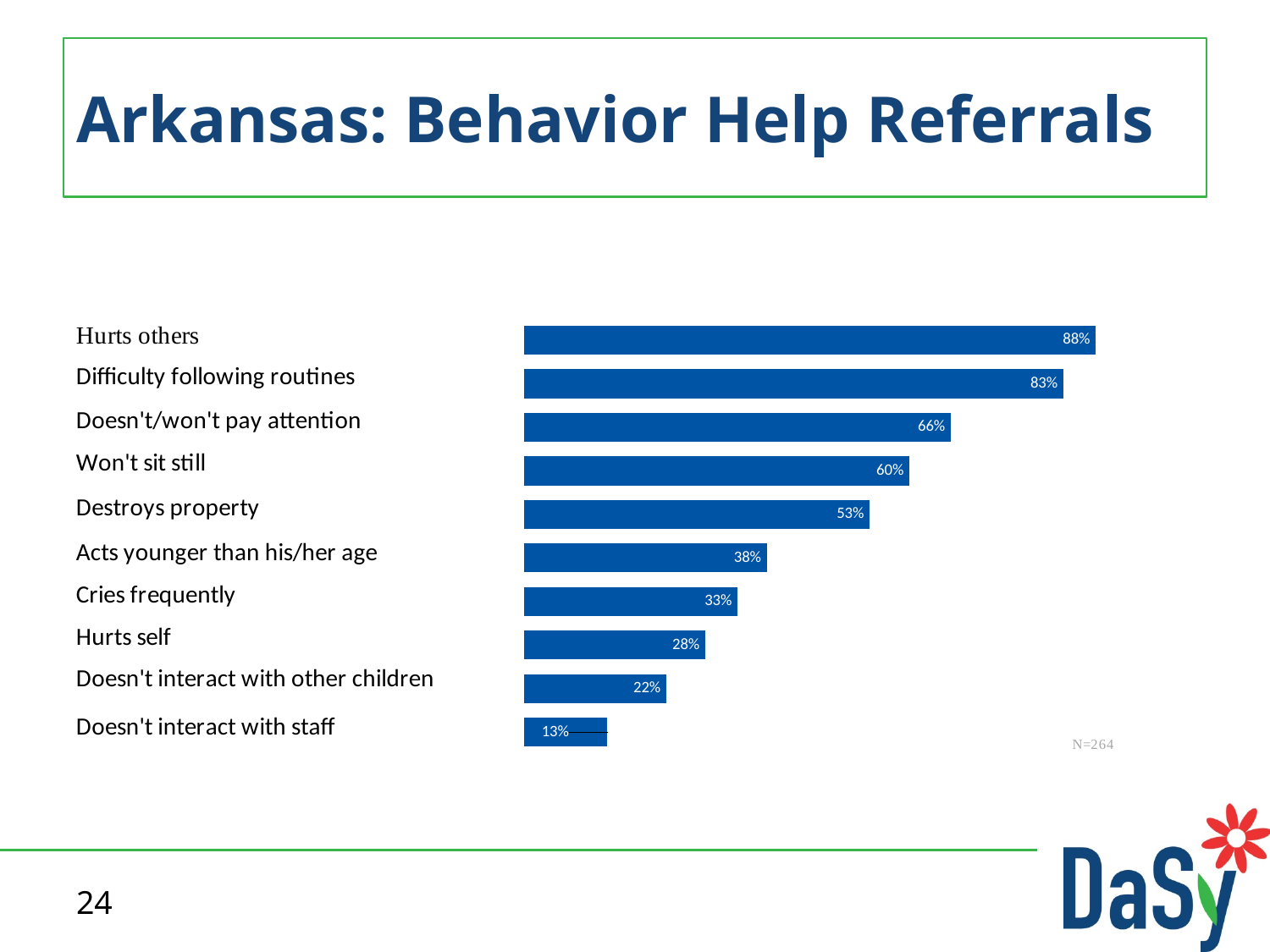
Which behavior has the lowest percentage? Doesn't interact with staff What is the difference between the percentages for "Difficulty following routines" and "Doesn't/won't pay attention"? 17% What percentage is shown for "Won't sit still"? 60% What is the difference between the percentages for "Hurts self" and "Doesn't interact with staff"? 15% What percentage is shown for "Hurts others"? 88% What percentage is shown for "Cries frequently"? 33% What kind of chart is shown on the slide? Bar chart Which behavior has the highest percentage? Hurts others How many behavior categories are shown in the chart? 10 Which is larger: the percentage for "Destroys property" or for "Acts younger than his/her age"? Destroys property What percentage is shown for "Doesn't interact with other children"? 22% What sample size (N) is noted on the chart? N=264